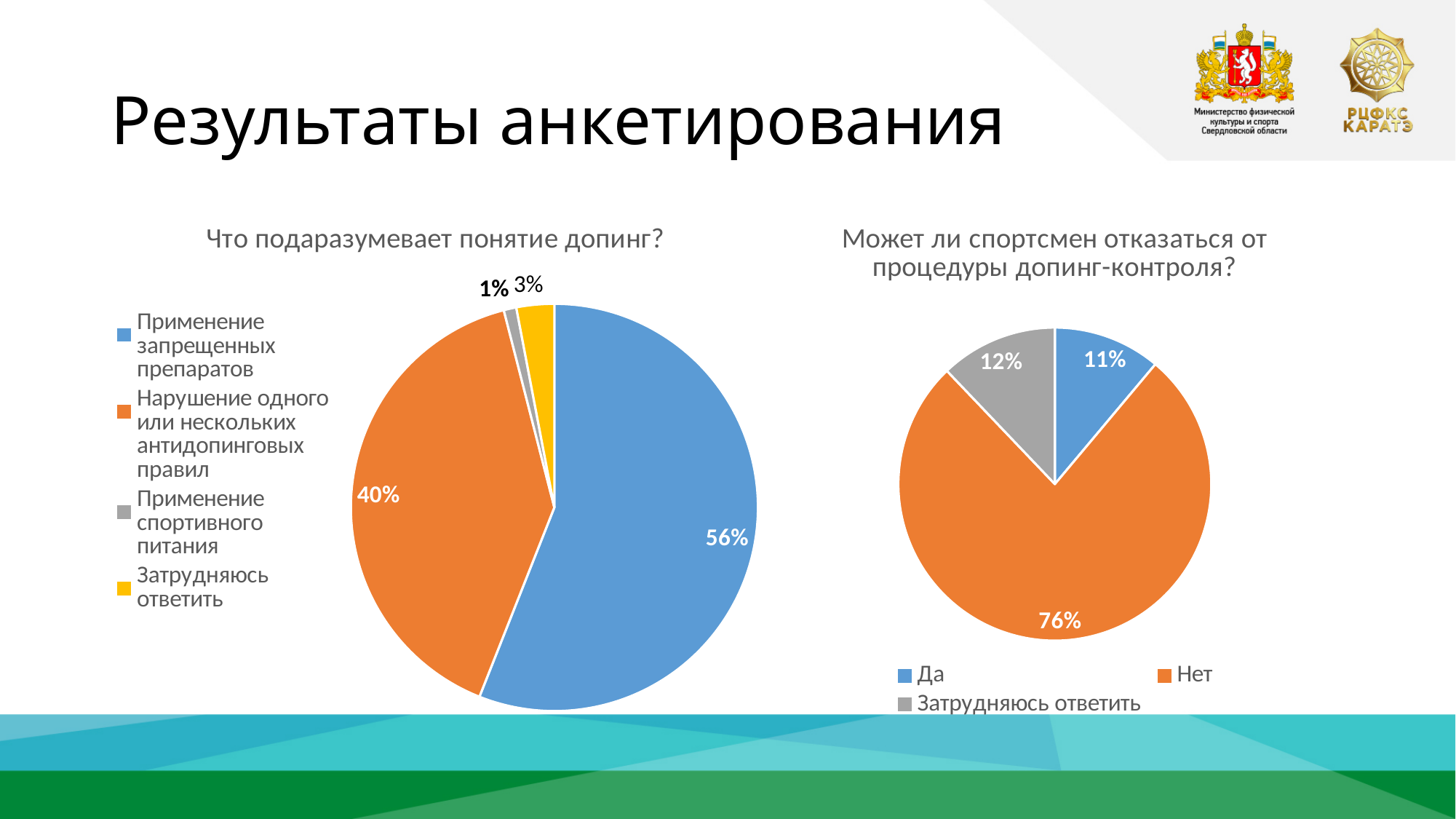
In the chart titled "Что подаразумевает понятие допинг?", what share is shown for "Применение запрещенных препаратов"? 56% In the chart titled "Может ли спортсмен отказаться от процедуры допинг-контроля?", which answer has the largest slice? Нет In the chart titled "Что подаразумевает понятие допинг?", how many categories does the legend list? 4 In the chart titled "Может ли спортсмен отказаться от процедуры допинг-контроля?", what colour is the slice for "Затрудняюсь ответить"? Gray In the chart titled "Может ли спортсмен отказаться от процедуры допинг-контроля?", what share answered "Нет"? 76% What type of chart is the one titled "Может ли спортсмен отказаться от процедуры допинг-контроля?"? Pie chart In the chart titled "Может ли спортсмен отказаться от процедуры допинг-контроля?", what is the difference between the shares for "Затрудняюсь ответить" and "Да"? 1% In the chart titled "Что подаразумевает понятие допинг?", what is the difference between the shares for "Применение запрещенных препаратов" and "Нарушение одного или нескольких антидопинговых правил"? 16% In the chart titled "Что подаразумевает понятие допинг?", what share is shown for "Нарушение одного или нескольких антидопинговых правил"? 40% In the chart titled "Что подаразумевает понятие допинг?", which category has the smallest slice? Применение спортивного питания In the chart titled "Что подаразумевает понятие допинг?", what share is shown for "Затрудняюсь ответить"? 3% In the chart titled "Может ли спортсмен отказаться от процедуры допинг-контроля?", what share answered "Да"? 11%